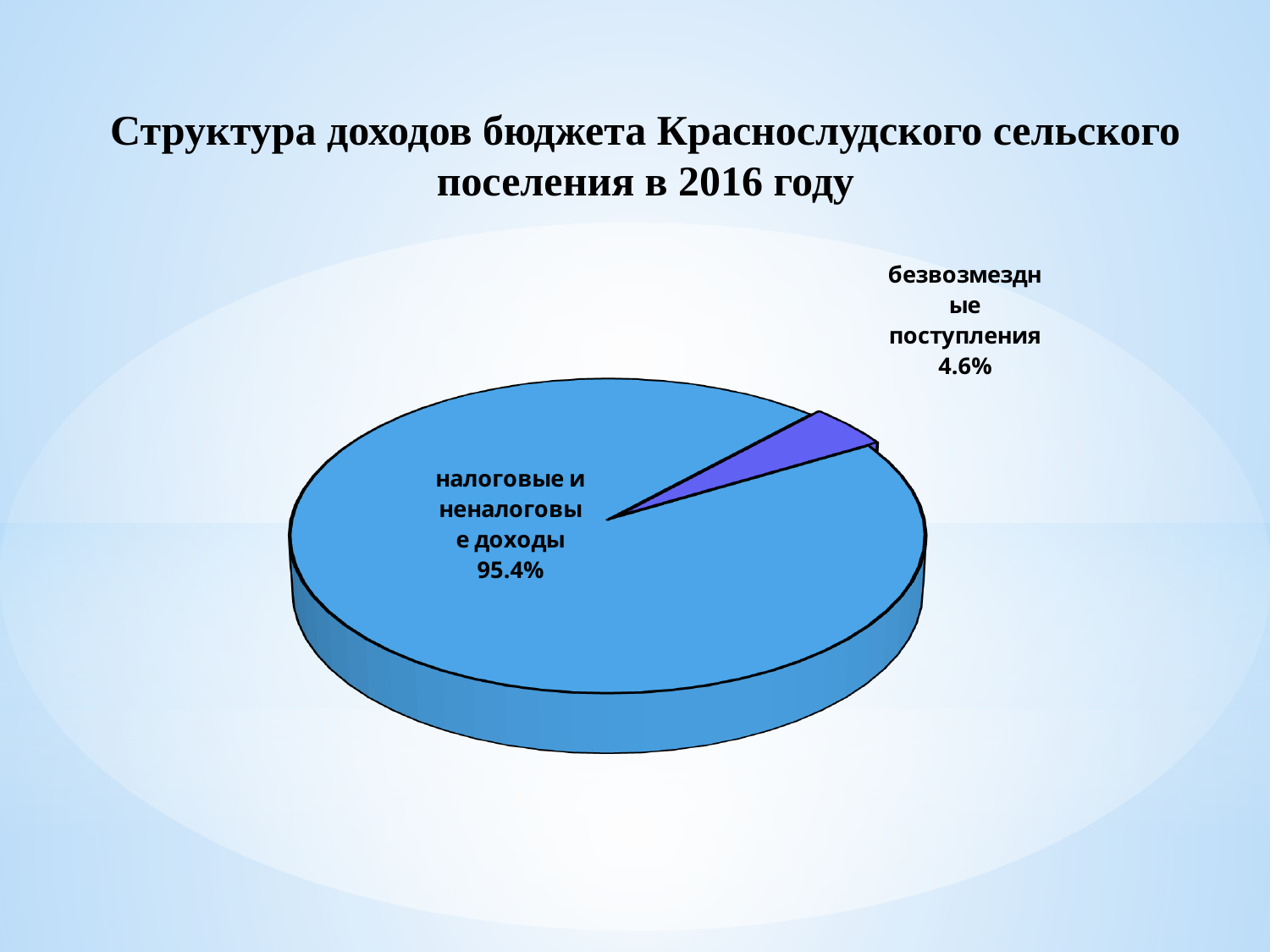
What colour is the slice for "безвозмездные поступления"? purple Which category has the smallest slice of the pie? безвозмездные поступления Is the share of "безвозмездные поступления" greater or less than 10%? less What share of the pie does "налоговые и неналоговые доходы" take? 95.4% What is the difference in percentage points between "налоговые и неналоговые доходы" and "безвозмездные поступления"? 90.8 Which is larger: the share of "налоговые и неналоговые доходы" or the share of "безвозмездные поступления"? налоговые и неналоговые доходы How many slices does the pie chart have? 2 Which category has the largest slice of the pie? налоговые и неналоговые доходы What is the title of the chart on the slide? Структура доходов бюджета Краснослудского сельского поселения в 2016 году What kind of chart is shown on the slide? pie chart What share of the pie does "безвозмездные поступления" take? 4.6%